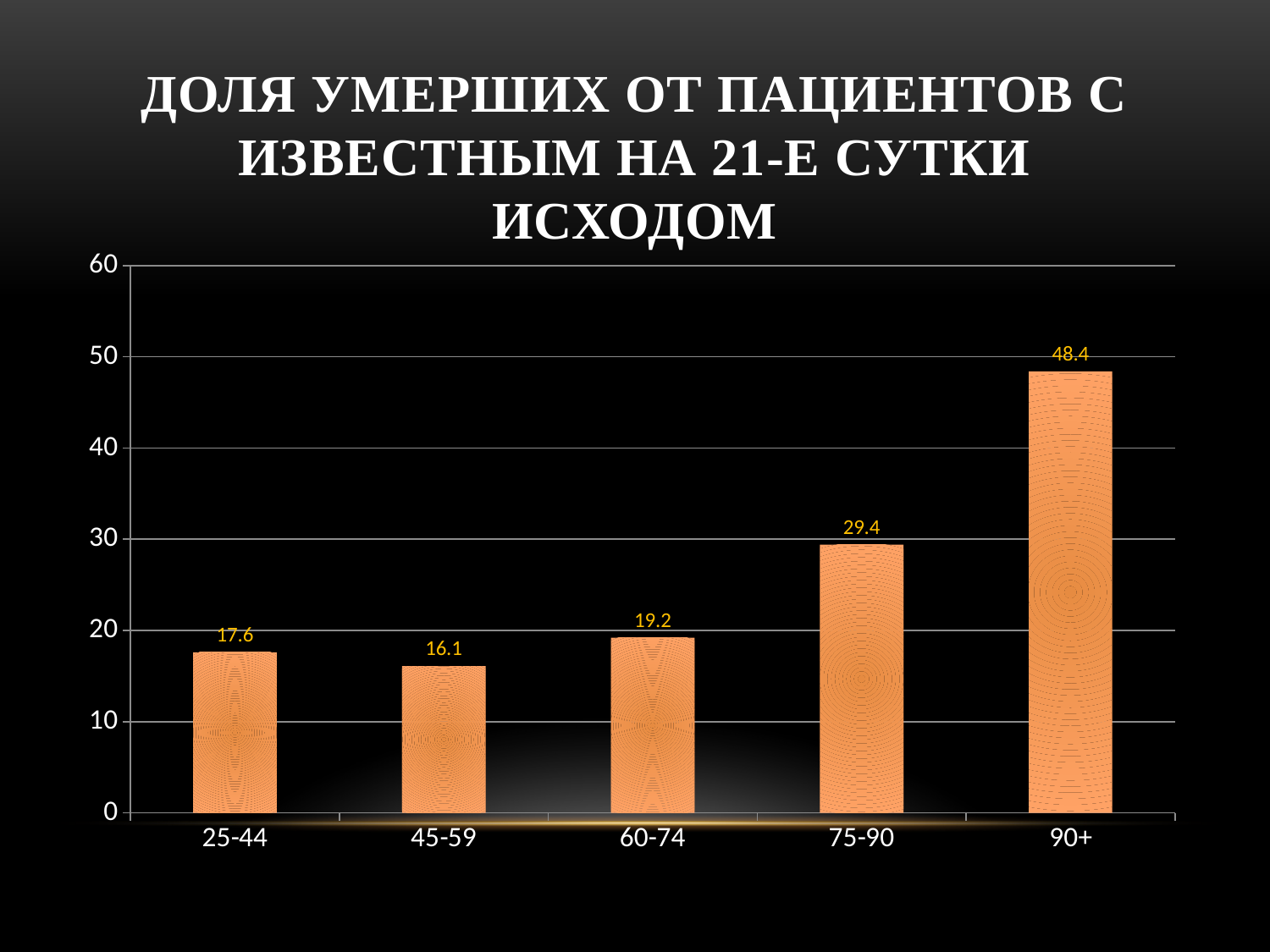
What is the value for the 90+ age group? 48.4 Which is larger, the value for 25-44 or the value for 60-74? 60-74 What is the difference between the values for 25-44 and 45-59? 1.5 What is the value for the 60-74 age group? 19.2 What is the value for the 45-59 age group? 16.1 Do the values rise or fall from the 45-59 group to the 90+ group? rise What kind of chart is shown on the slide? bar chart What is the difference between the values for 90+ and 75-90? 19 Which age group has the lowest value? 45-59 Which age group has the highest value? 90+ Is the value for 75-90 greater or less than 30? less How many age groups are shown on the x axis? 5